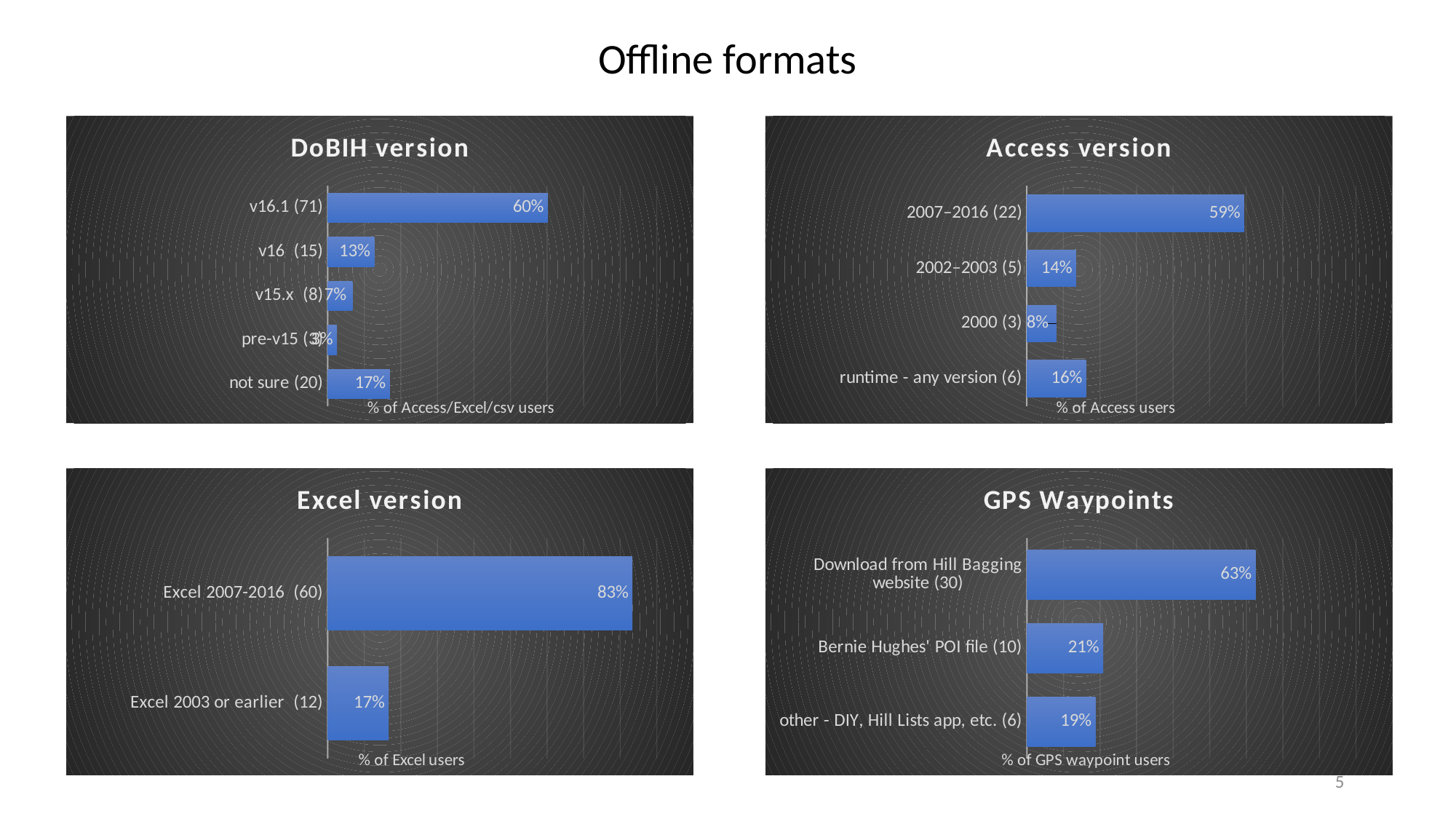
In the Access version chart, how many categories are plotted? 4 In the Access version chart, what percentage is shown for 2002–2003? 14% In the GPS Waypoints chart, which is larger: the value for Bernie Hughes' POI file or the value for other - DIY, Hill Lists app, etc.? Bernie Hughes' POI file In the DoBIH version chart, what percentage is shown for v16.1? 60% In the DoBIH version chart, which category has the highest value? v16.1 (71) In the Excel version chart, what is the difference between the values for Excel 2007-2016 and Excel 2003 or earlier? 66% In the Excel version chart, what percentage is shown for Excel 2007-2016? 83% In the GPS Waypoints chart, what percentage is shown for Bernie Hughes' POI file? 21% What is the x-axis label of the Excel version chart? % of Excel users In the Access version chart, which category has the lowest value? 2000 (3) What kind of chart is the GPS Waypoints chart? Bar chart In the DoBIH version chart, what is the difference between the values for not sure and v16? 4%